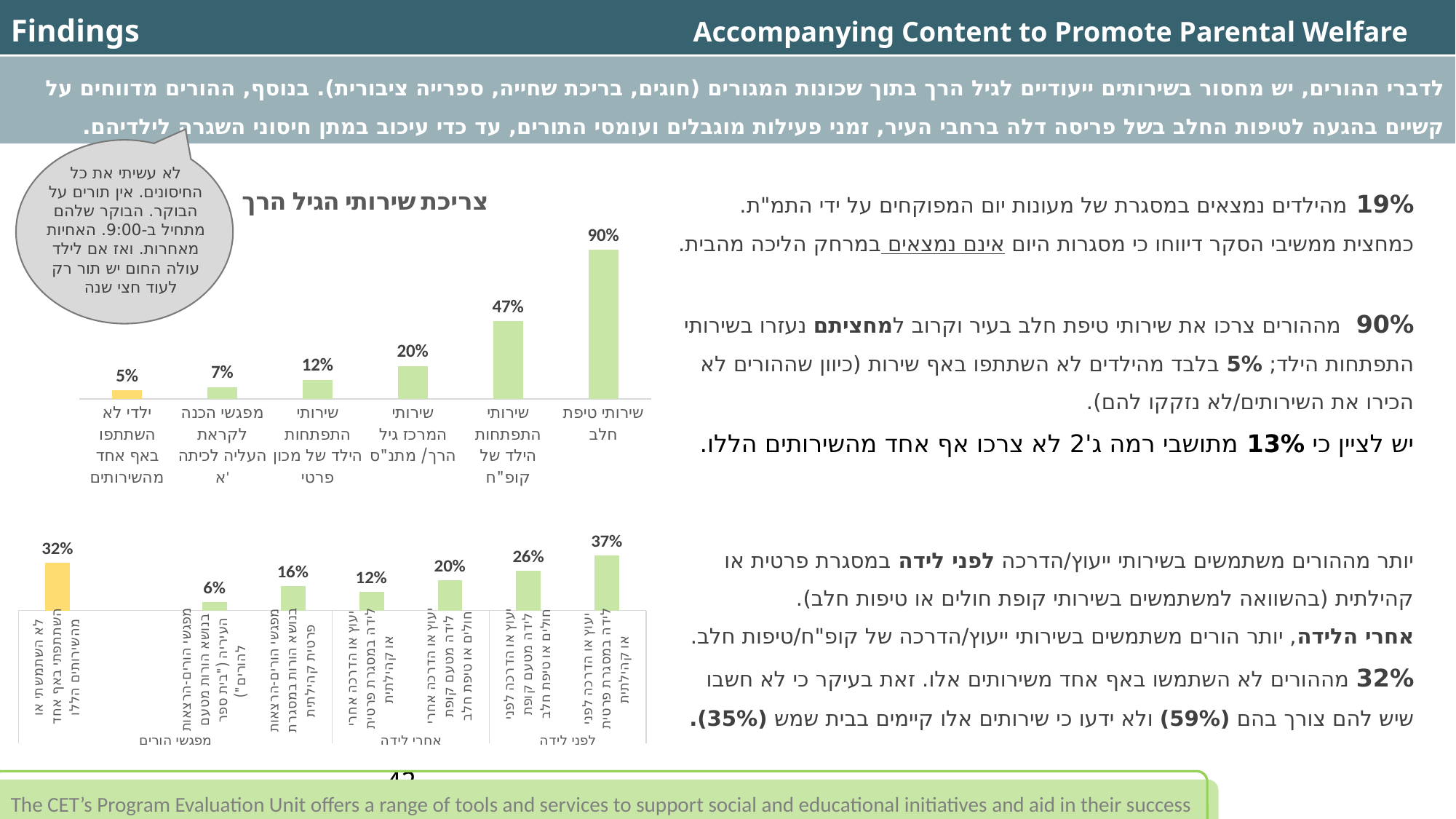
In the top chart titled 'צריכת שירותי הגיל הרך', how many categories are shown? 6 In the bottom chart, what is the lowest value shown? 6% In the top chart titled 'צריכת שירותי הגיל הרך', what is the value for 'שירותי התפתחות הילד של קופ"ח'? 47% In the bottom chart, what is the difference between the 'לפני לידה' bar at 37% and the 'אחרי לידה' bar at 20%? 17% In the bottom chart, how many bars are shown? 7 In the top chart titled 'צריכת שירותי הגיל הרך', what is the difference between 'שירותי טיפת חלב' and 'שירותי התפתחות הילד של קופ"ח'? 43% In the top chart titled 'צריכת שירותי הגיל הרך', what is the value for 'שירותי טיפת חלב'? 90% In the bottom chart, what is the value for 'לא השתמשתי באף אחד מהשירותים הללו'? 32% In the bottom chart, which category has the highest value? ייעוץ או הדרכה לפני לידה במסגרת פרטית או קהילתית What kind of chart is the top chart titled 'צריכת שירותי הגיל הרך'? Bar chart In the top chart titled 'צריכת שירותי הגיל הרך', which is larger: 'שירותי המרכז גיל הרך/ מתנ"ס' or 'שירותי התפתחות הילד של מכון פרטי'? שירותי המרכז גיל הרך/ מתנ"ס In the top chart titled 'צריכת שירותי הגיל הרך', which category has the lowest value? ילדי לא השתתפו באף אחד מהשירותים